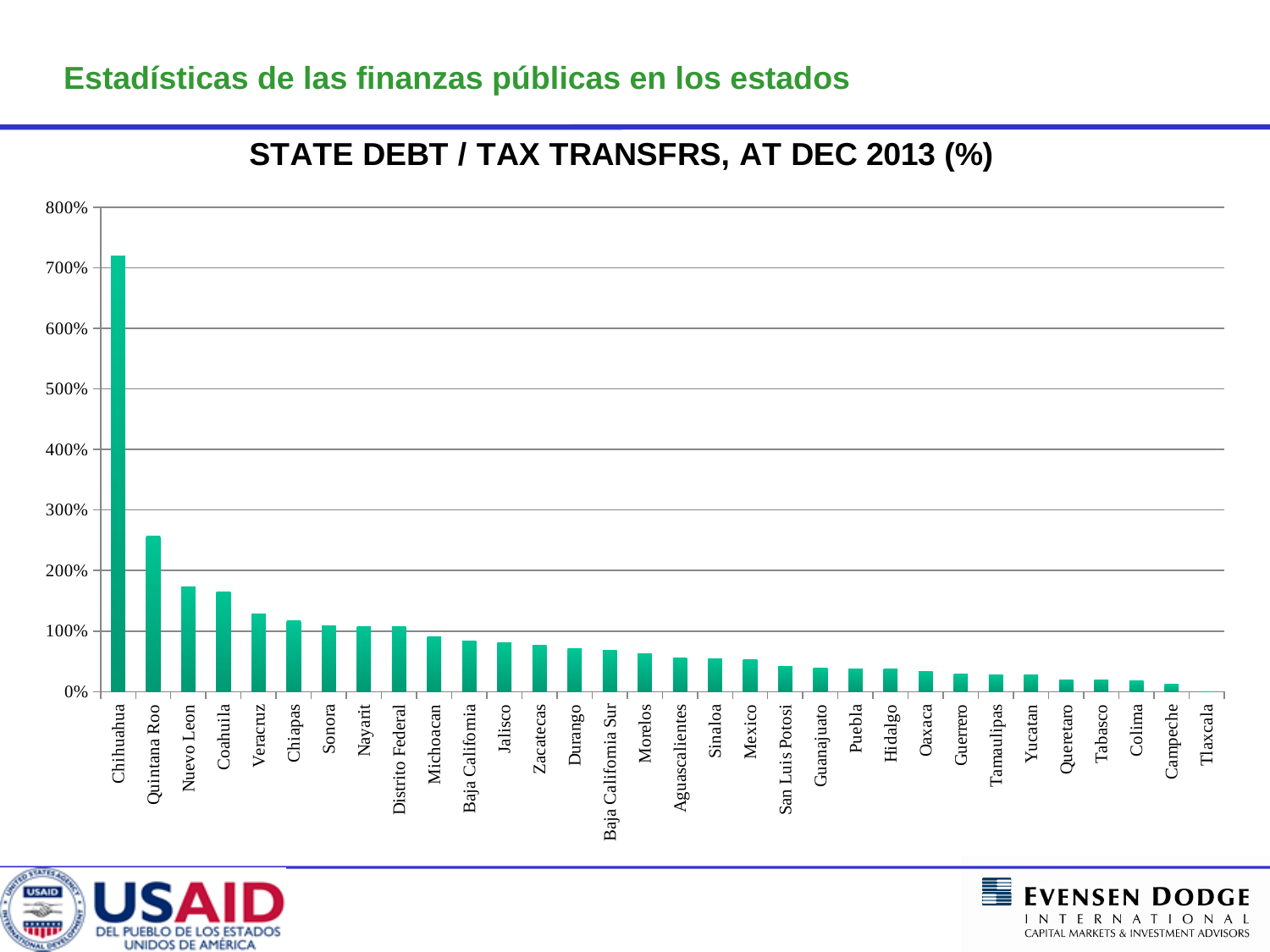
How many states are shown on the x axis of the chart? 32 Is the value for Quintana Roo greater or less than 200%? greater Is the value for Michoacan greater or less than 100%? less What is the title of the chart? STATE DEBT / TAX TRANSFRS, AT DEC 2013 (%) Is the value for Campeche greater or less than 100%? less Do the values rise or fall moving from left to right along the x axis? fall Which state has the lowest value in the chart? Tlaxcala Which has the larger value, Quintana Roo or Nuevo Leon? Quintana Roo Which state has the highest value in the chart? Chihuahua What kind of chart is shown on the slide? bar chart